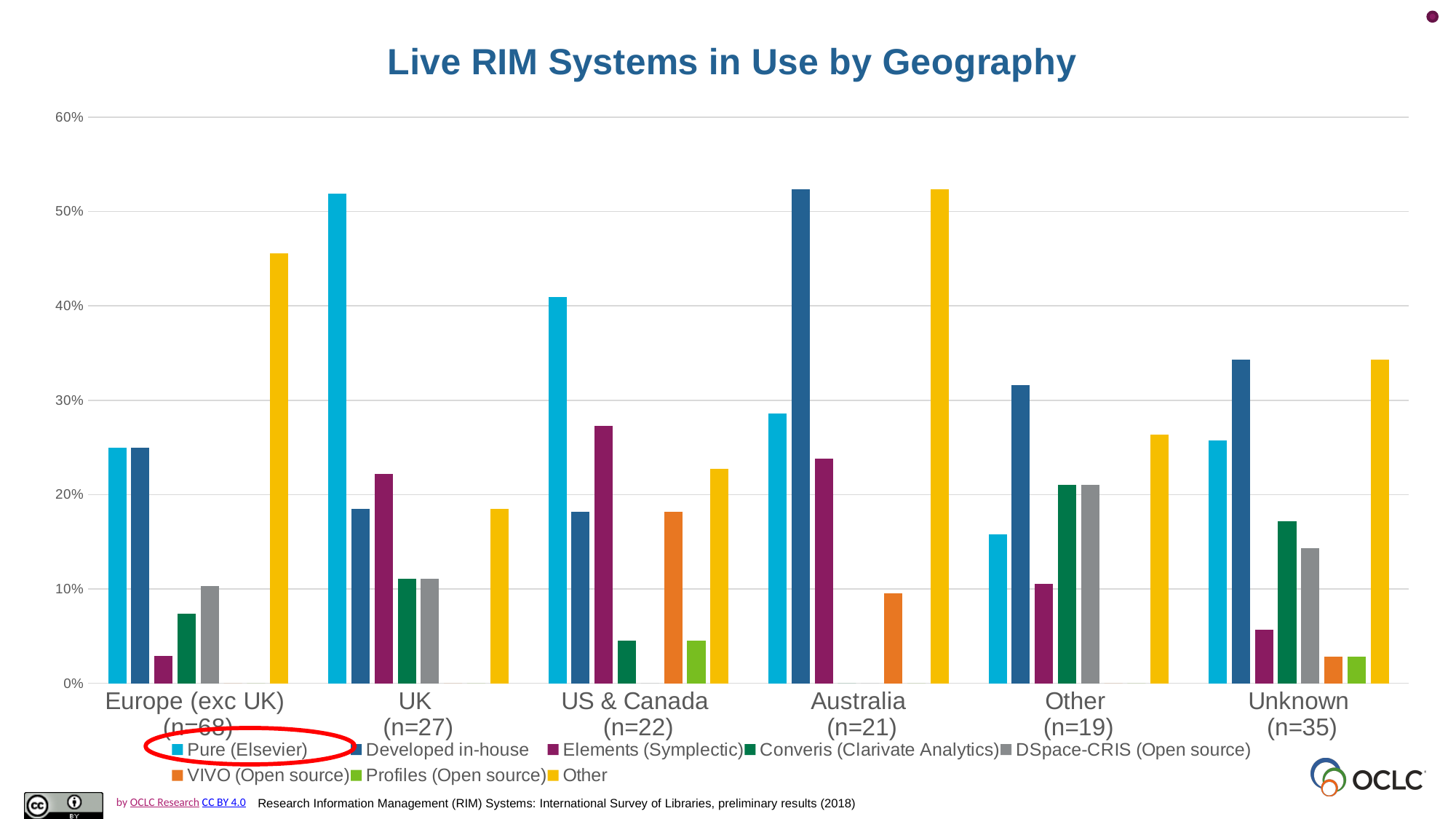
Is the Elements (Symplectic) value for Unknown (n=35) greater or less than 10%? less Is the Other value for Europe (exc UK) (n=68) greater or less than 40%? greater How many geographic categories are shown on the x axis? 6 Which geographic category has the highest Pure (Elsevier) value? UK (n=27) Is the Pure (Elsevier) value for UK (n=27) greater or less than 40%? greater How many series does the legend list? 8 For Europe (exc UK) (n=68), which is larger: Converis (Clarivate Analytics) or DSpace-CRIS (Open source)? DSpace-CRIS (Open source) What kind of chart is shown on the slide? bar chart Which legend entry is circled in red? Pure (Elsevier) Which series has the highest value for US & Canada (n=22)? Pure (Elsevier) What is the title of the chart? Live RIM Systems in Use by Geography